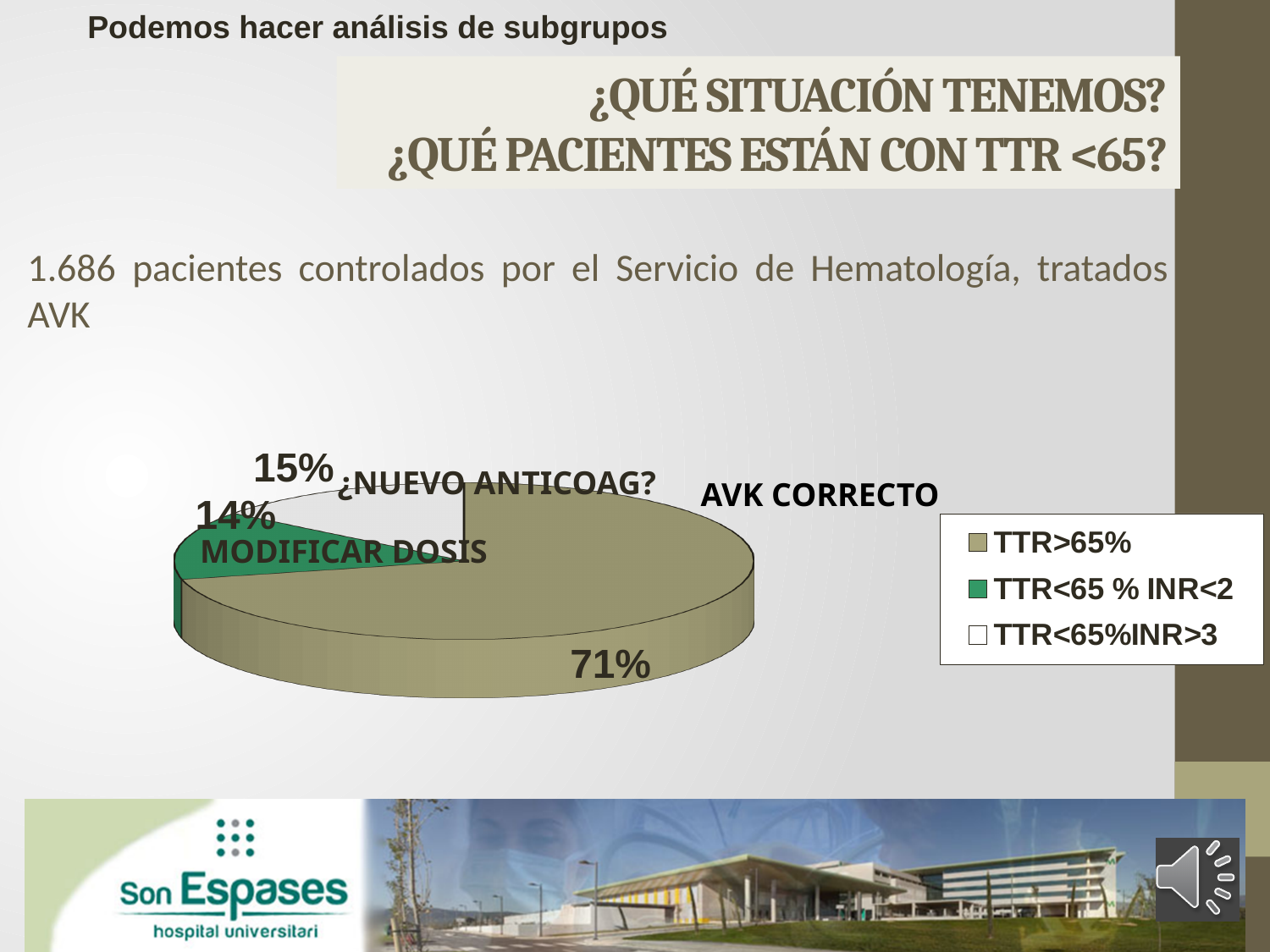
What kind of chart is shown on the slide? pie chart How many entries does the legend of the pie chart list? 3 What share of the pie does the TTR<65 % INR<2 slice represent? 14% Which slice of the pie is the smallest? TTR<65 % INR<2 What is the difference in percentage points between the TTR>65% slice and the TTR<65%INR>3 slice? 56 What share of the pie does the TTR>65% slice represent? 71% What colour is the TTR<65 % INR<2 slice in the pie chart? green How many slices does the pie chart have? 3 Which slice of the pie is the largest? TTR>65% What text label is placed next to the 71% slice of the pie chart? AVK CORRECTO What share of the pie does the TTR<65%INR>3 slice represent? 15% Which is larger, the TTR<65%INR>3 slice or the TTR<65 % INR<2 slice? TTR<65%INR>3